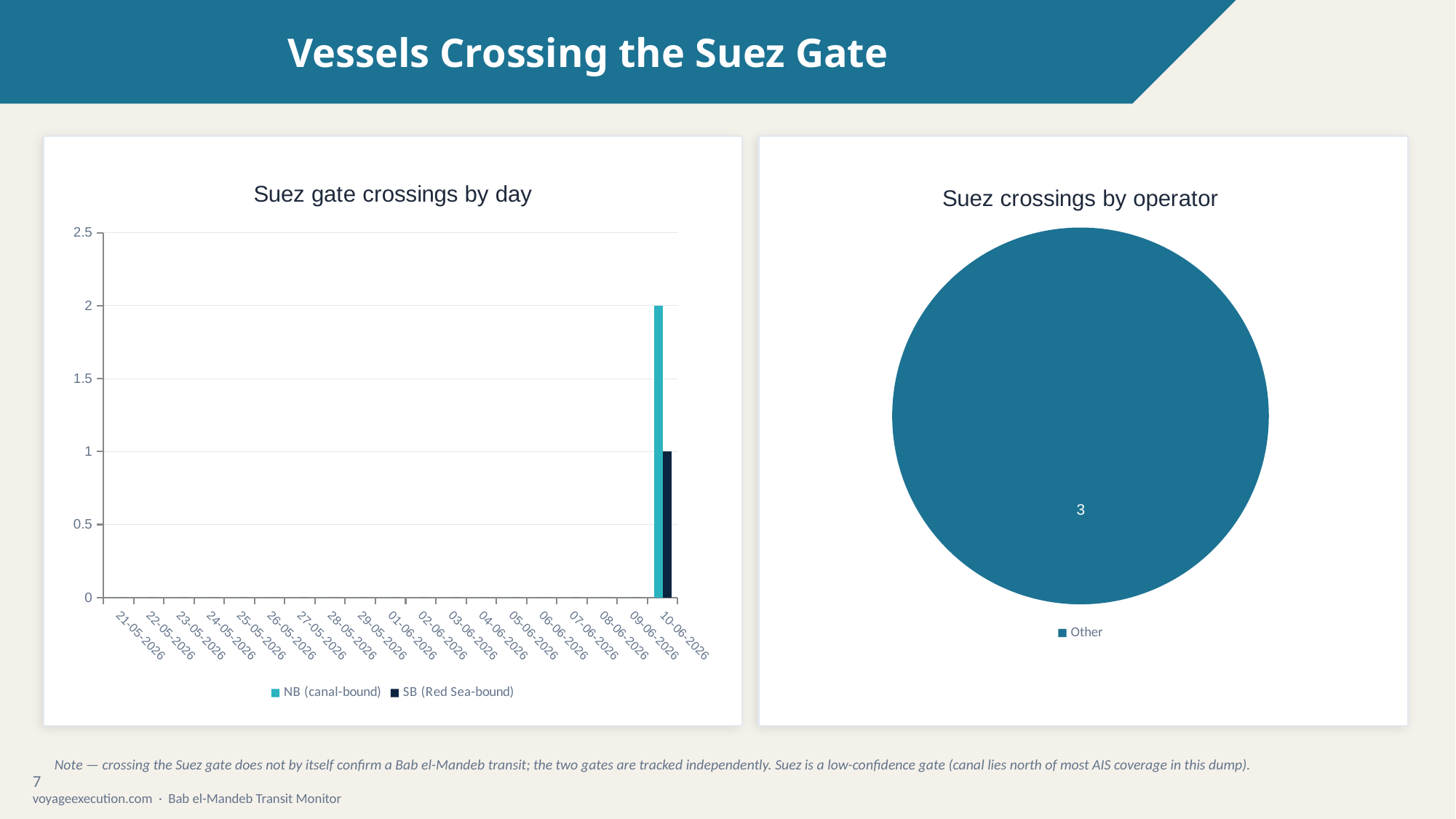
In the 'Suez gate crossings by day' chart, how many series does the legend list? 2 In the 'Suez gate crossings by day' chart, what is the difference between the NB (canal-bound) and SB (Red Sea-bound) values on 10-06-2026? 1 In the 'Suez crossings by operator' chart, what is the value of the 'Other' slice? 3 In the 'Suez gate crossings by day' chart, which series has the larger value on 10-06-2026, NB (canal-bound) or SB (Red Sea-bound)? NB (canal-bound) What kind of chart is 'Suez gate crossings by day'? Bar chart In the 'Suez gate crossings by day' chart, how many dates are shown on the x axis? 19 In the 'Suez gate crossings by day' chart, what is the SB (Red Sea-bound) value on 10-06-2026? 1 In the 'Suez crossings by operator' chart, how many categories does the legend list? 1 In the 'Suez gate crossings by day' chart, is the NB (canal-bound) value on 10-06-2026 greater or less than 1.5? greater What kind of chart is 'Suez crossings by operator'? Pie chart In the 'Suez gate crossings by day' chart, what is the NB (canal-bound) value on 10-06-2026? 2 In the 'Suez gate crossings by day' chart, on which date is the NB (canal-bound) value highest? 10-06-2026